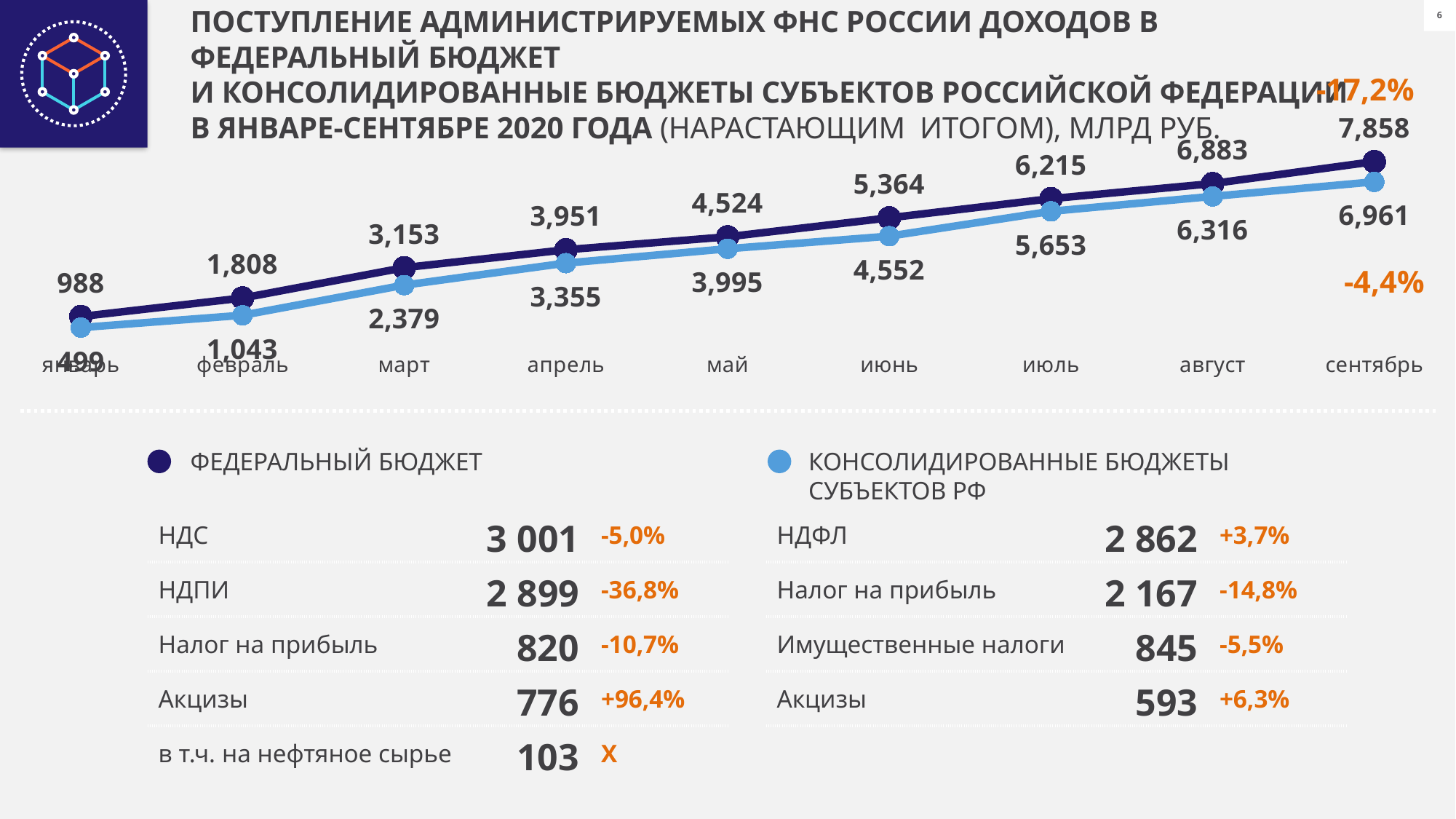
How many months are plotted along the x axis of the chart? 9 In which month is the value for ФЕДЕРАЛЬНЫЙ БЮДЖЕТ lowest? январь In which month is the value for КОНСОЛИДИРОВАННЫЕ БЮДЖЕТЫ СУБЪЕКТОВ РФ highest? сентябрь Which series has the larger value in май: ФЕДЕРАЛЬНЫЙ БЮДЖЕТ or КОНСОЛИДИРОВАННЫЕ БЮДЖЕТЫ СУБЪЕКТОВ РФ? ФЕДЕРАЛЬНЫЙ БЮДЖЕТ What is the value for ФЕДЕРАЛЬНЫЙ БЮДЖЕТ in март? 3,153 How many series does the chart legend list? 2 What is the value for ФЕДЕРАЛЬНЫЙ БЮДЖЕТ in сентябрь? 7,858 What type of chart is shown on the slide? Line chart Do the values for ФЕДЕРАЛЬНЫЙ БЮДЖЕТ rise or fall from январь to сентябрь? Rise What is the value for КОНСОЛИДИРОВАННЫЕ БЮДЖЕТЫ СУБЪЕКТОВ РФ in июль? 5,653 What is the value for КОНСОЛИДИРОВАННЫЕ БЮДЖЕТЫ СУБЪЕКТОВ РФ in апрель? 3,355 What is the difference between ФЕДЕРАЛЬНЫЙ БЮДЖЕТ and КОНСОЛИДИРОВАННЫЕ БЮДЖЕТЫ СУБЪЕКТОВ РФ in сентябрь? 897